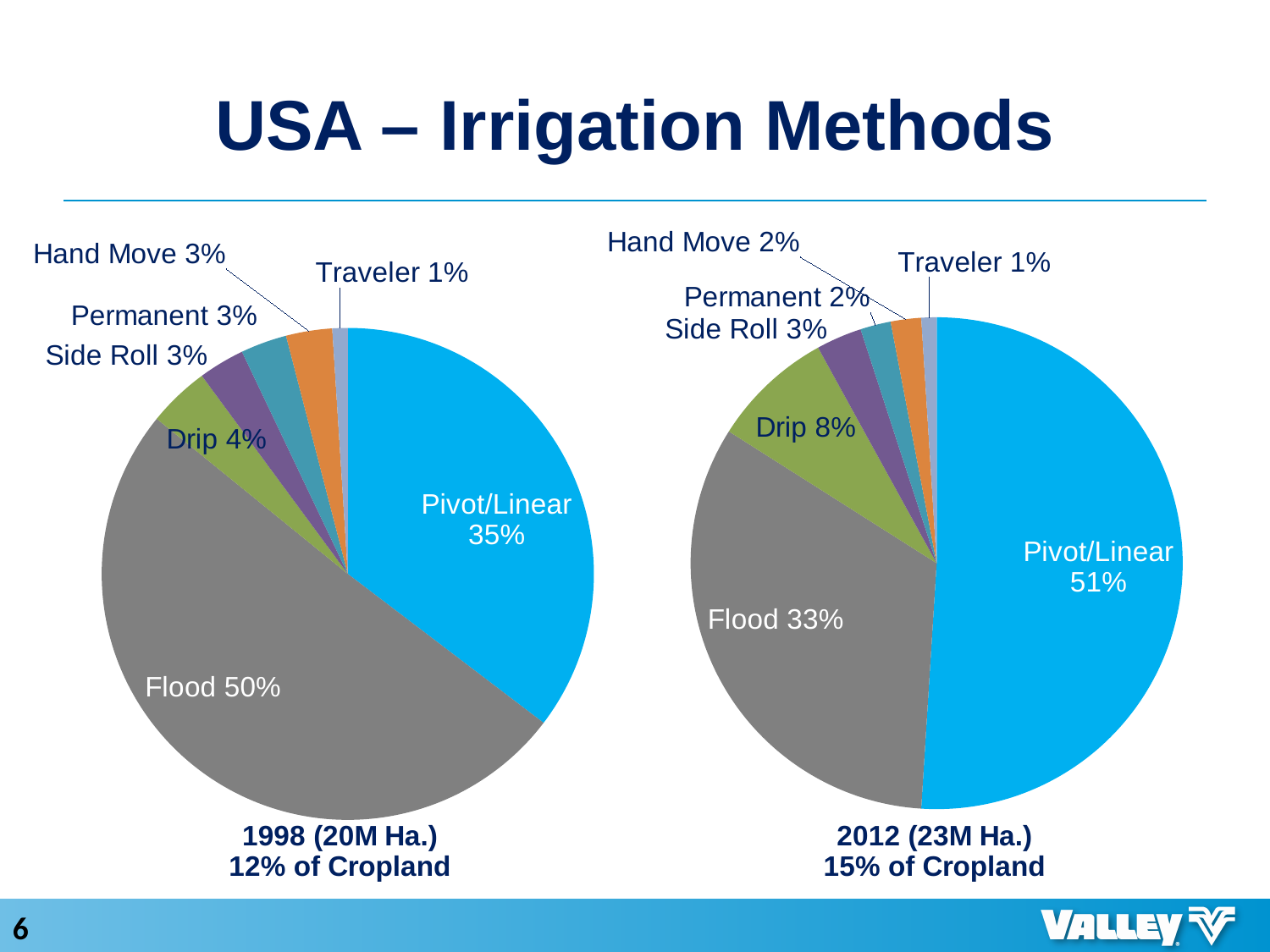
In the 2012 pie chart, what share does Drip have? 8% In the 1998 pie chart, what is the difference between the Flood share and the Pivot/Linear share? 15% In the 2012 pie chart, what share does Pivot/Linear have? 51% In the 2012 pie chart, which irrigation method has the largest share? Pivot/Linear In the 1998 pie chart, what share does Flood have? 50% What is the title of the slide? USA – Irrigation Methods In the 1998 pie chart, which irrigation method has the smallest share? Traveler In the 2012 pie chart, which is larger, the Drip share or the Side Roll share? Drip In the 2012 pie chart, what is the difference between the Pivot/Linear share and the Flood share? 18% What kind of chart is used on this slide? Pie chart In the 1998 pie chart, which irrigation method has the largest share? Flood How many slices does the 1998 pie chart have? 7